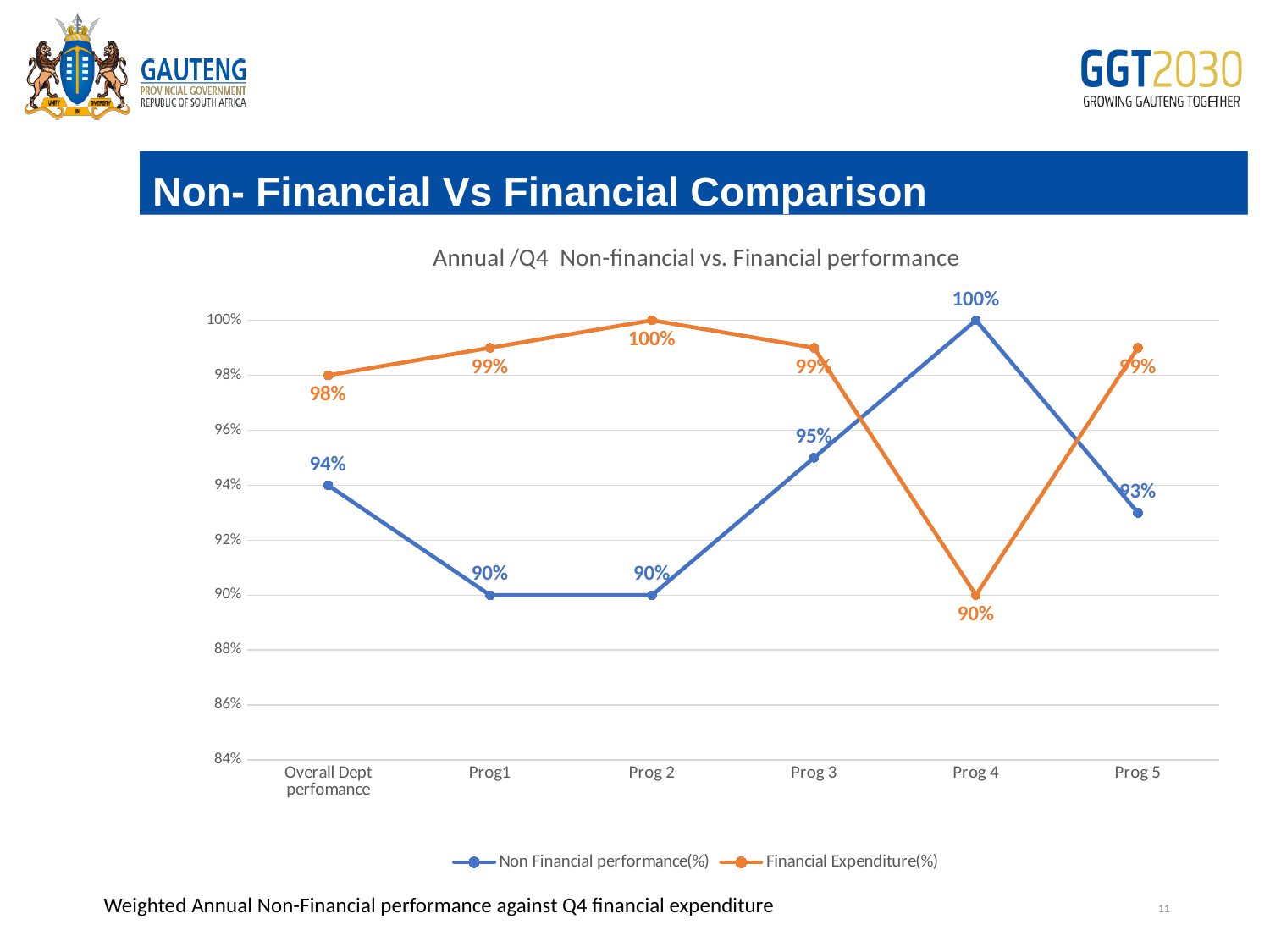
What is the difference between the Financial Expenditure(%) and Non Financial performance(%) values for Prog 2? 10% For Prog 3, which is larger: Non Financial performance(%) or Financial Expenditure(%)? Financial Expenditure(%) Which category has the highest Non Financial performance(%) value? Prog 4 How many series does the legend list? 2 How many categories are shown on the x axis? 6 What is the Financial Expenditure(%) value for Overall Dept perfomance? 98% What kind of chart is shown on the slide? Line chart What is the Financial Expenditure(%) value for Prog 4? 90% What is the title of the chart? Annual /Q4 Non-financial vs. Financial performance Which category has the lowest Financial Expenditure(%) value? Prog 4 What is the Non Financial performance(%) value for Prog 4? 100% What is the Non Financial performance(%) value for Prog 5? 93%